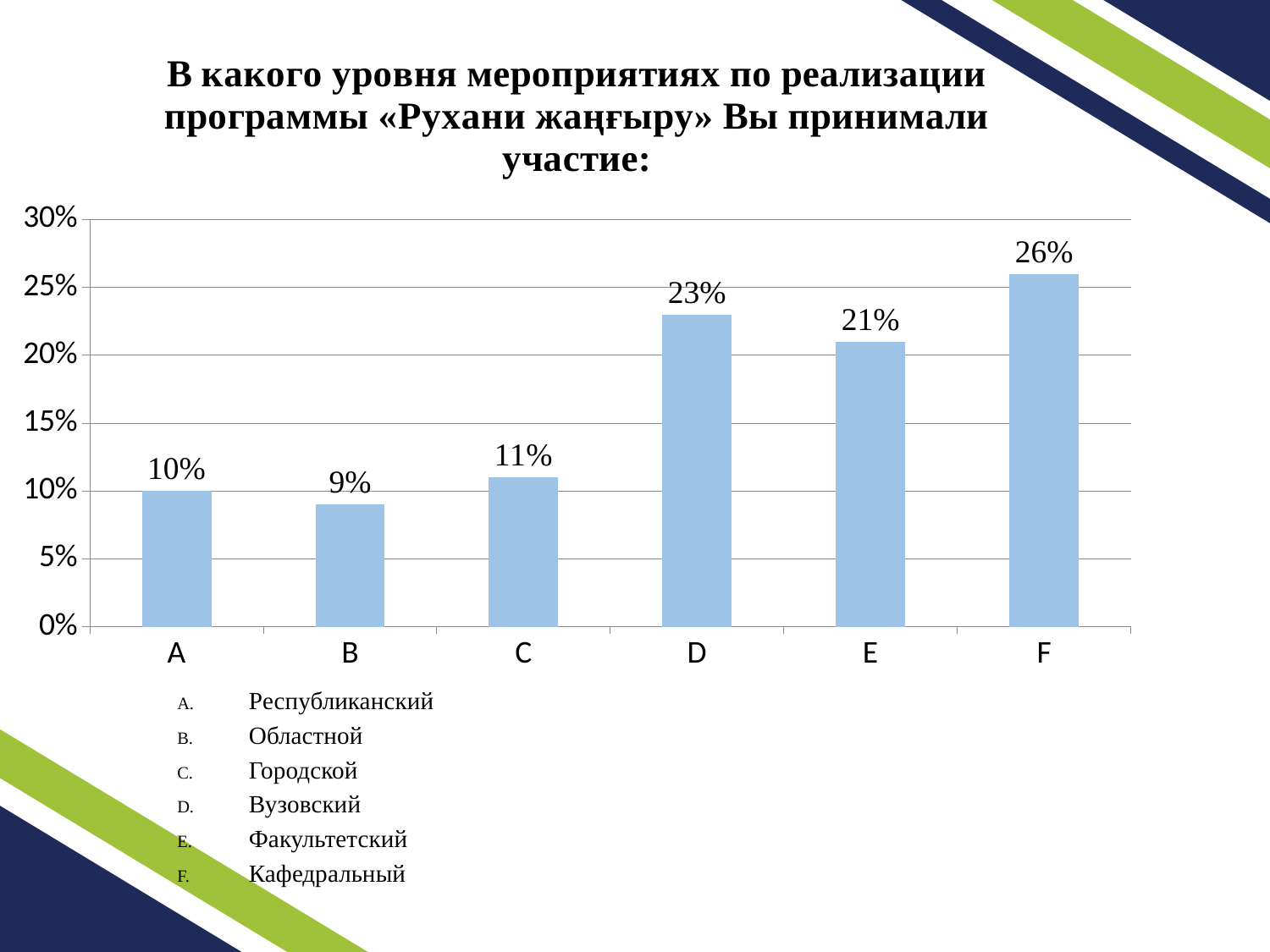
What kind of chart is shown on the slide? bar chart What is the value for category B? 9% What is the value for category D? 23% How many categories are shown on the x axis? 6 Which category has the lowest value? B Which is larger, the value for D or the value for E? D According to the key below the chart, what does category D stand for? Вузовский Which category has the highest value? F What is the value for category F? 26% What is the difference between the values for C and A? 1% Is the value for E greater or less than 20%? greater What is the difference between the values for F and D? 3%